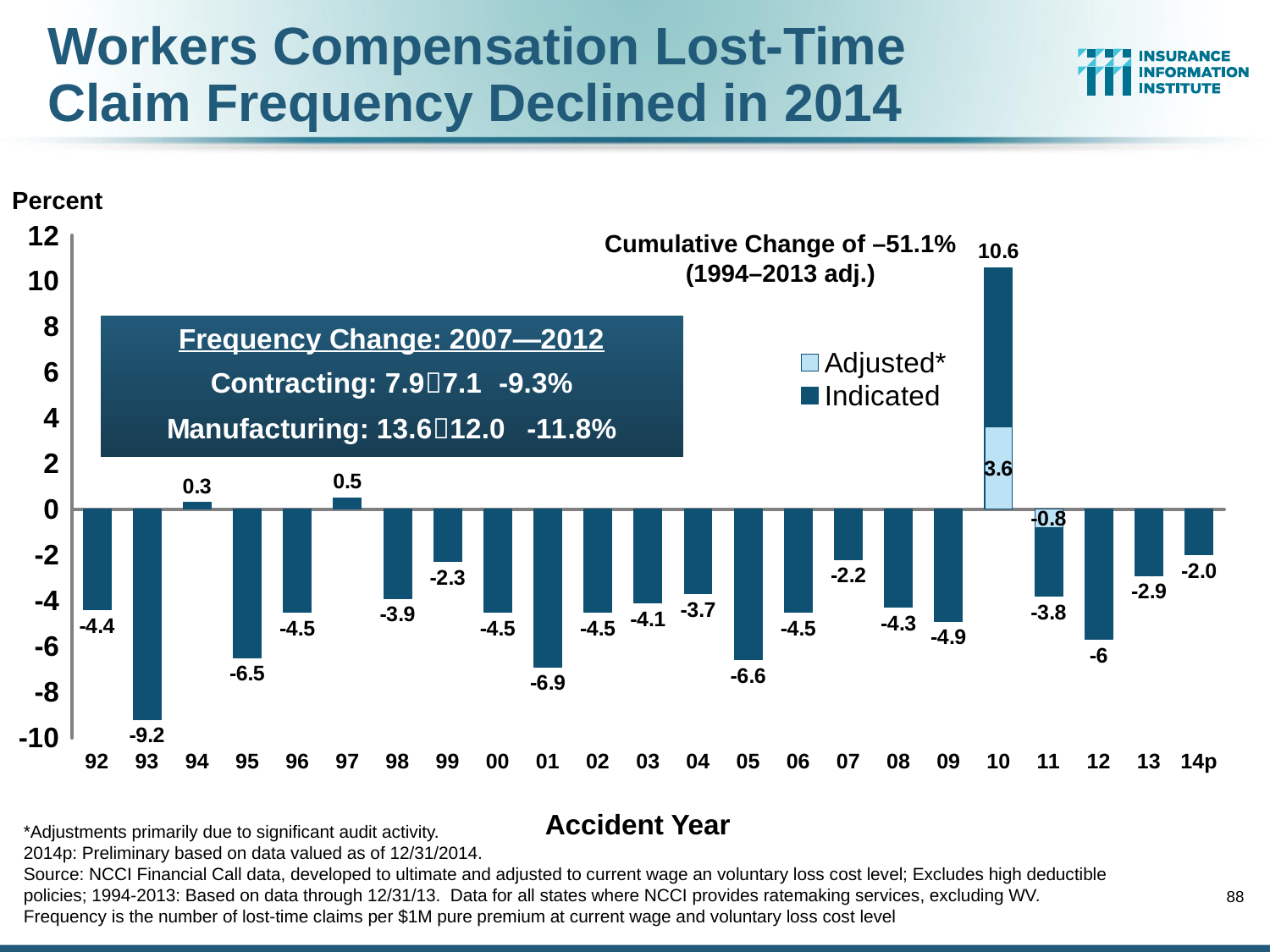
Which accident year has the highest Indicated value? 10 Which accident year has the lowest value? 93 What is the difference between the values for accident years 12 and 13? 3.1 How many series does the legend list? 2 What is the title of the x axis? Accident Year What kind of chart is shown on the slide? bar chart What is the Adjusted value shown for accident year 10? 3.6 Which is larger, the value for accident year 01 or for accident year 05? 05 What is the value shown for accident year 14p? -2.0 How many accident years are shown on the x axis? 23 What is the value shown for accident year 97? 0.5 What is the percent change in lost-time claim frequency for accident year 93? -9.2